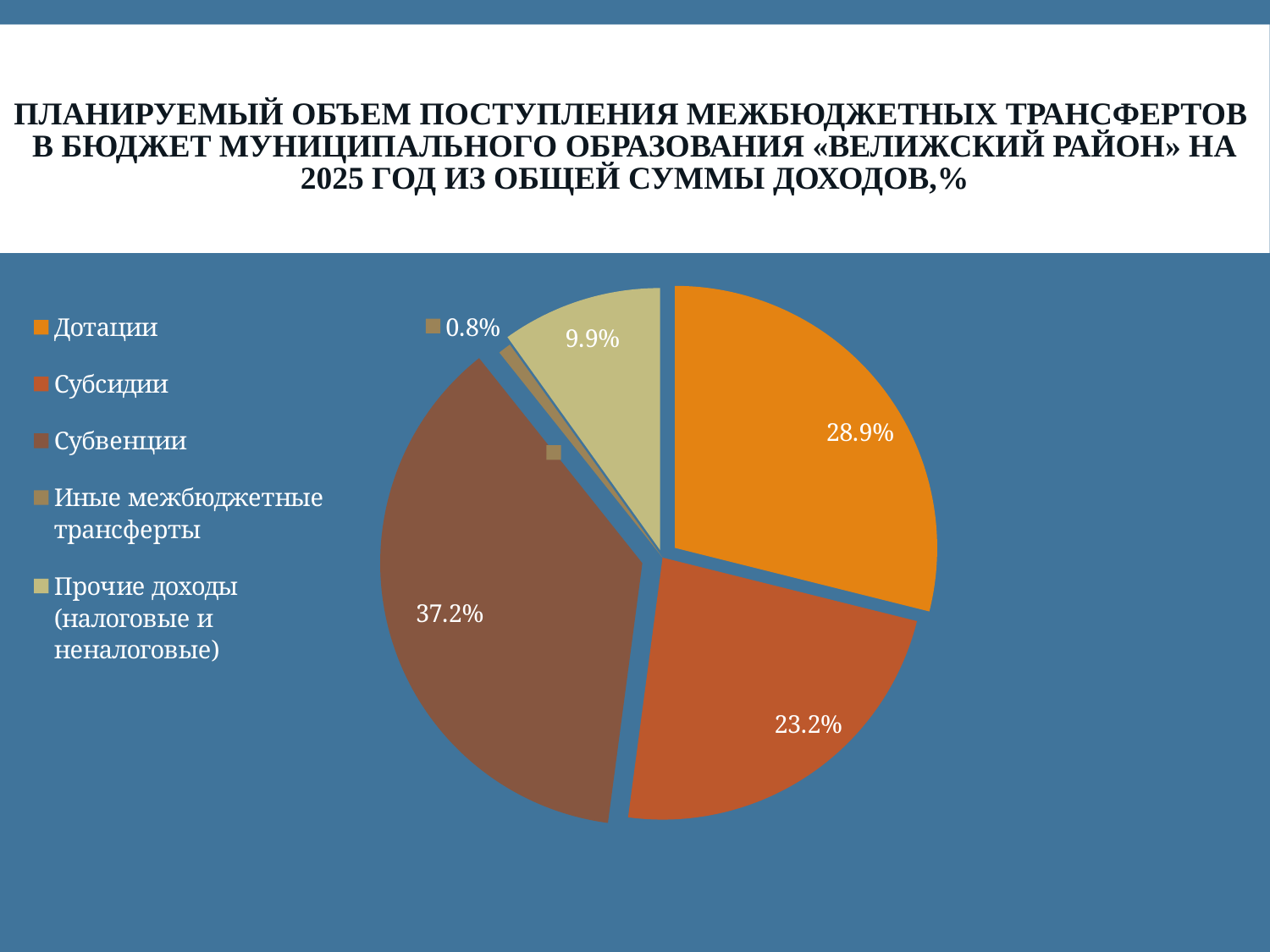
What is the value shown for Субсидии? 23.2% What share of the pie does Дотации account for? 28.9% What is the value shown for Субвенции? 37.2% What is the value shown for Прочие доходы (налоговые и неналоговые)? 9.9% What is the value shown for Иные межбюджетные трансферты? 0.8% Which is larger, the share for Дотации or the share for Субсидии? Дотации What type of chart is shown on the slide? Pie chart Which category has the smallest share of the pie? Иные межбюджетные трансферты Which category has the largest share of the pie? Субвенции What colour is the slice for Дотации? Orange How many categories does the legend list? 5 What is the difference in percentage points between Субвенции and Дотации? 8.3